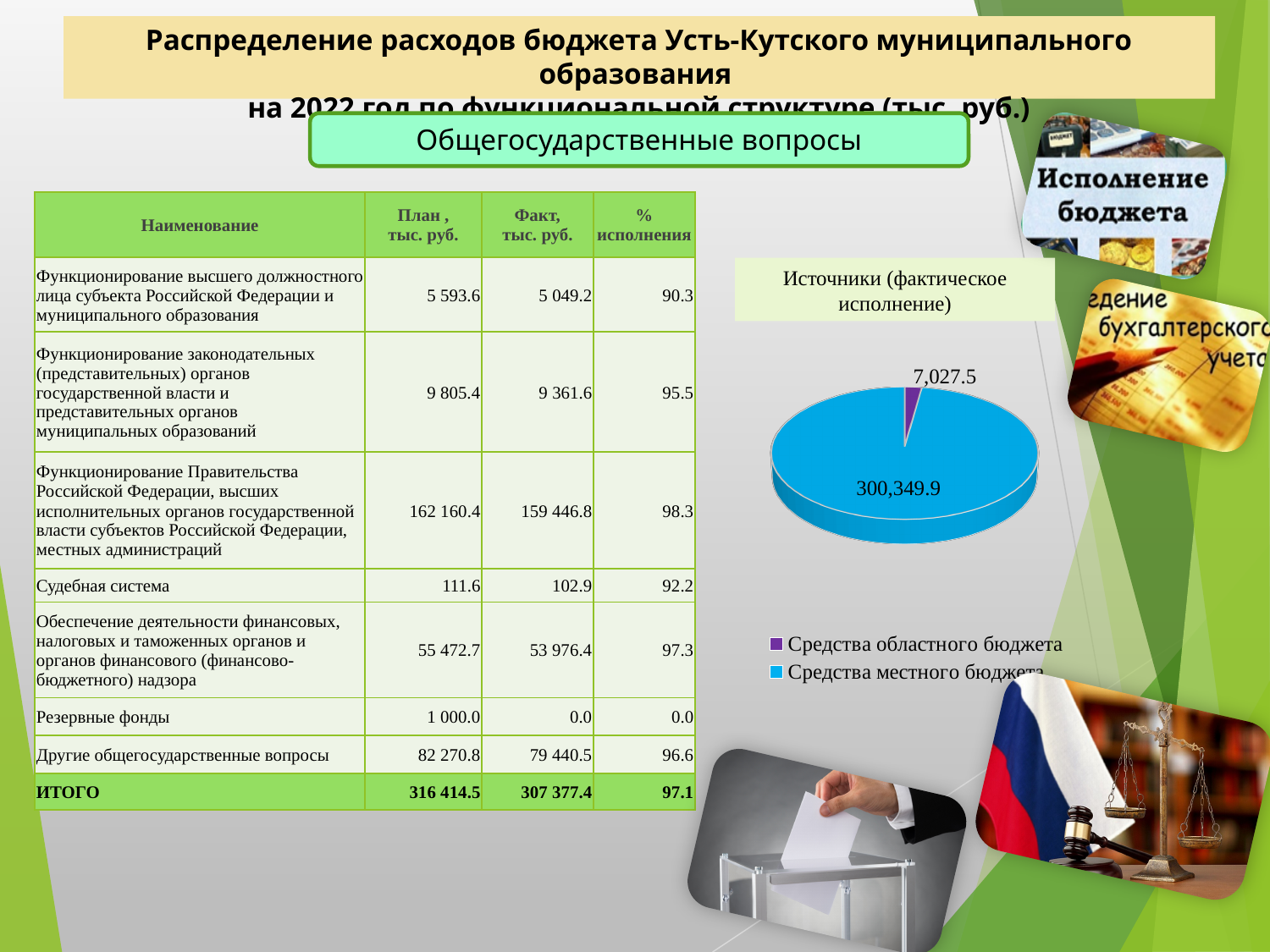
What is the value for Средства местного бюджета in the pie chart? 300,349.9 What is the value for Средства областного бюджета in the pie chart? 7,027.5 How many series does the legend of the pie chart list? 2 Which is larger in the pie chart: Средства областного бюджета or Средства местного бюджета? Средства местного бюджета Which slice of the pie chart is the largest? Средства местного бюджета What is the total of the two slices in the pie chart? 307,377.4 How many slices does the pie chart have? 2 What kind of chart is shown on the slide? pie chart What colour is the slice for Средства областного бюджета in the pie chart? purple Which slice of the pie chart is the smallest? Средства областного бюджета What is the difference between Средства местного бюджета and Средства областного бюджета in the pie chart? 293,322.4 What is the title of the pie chart? Источники (фактическое исполнение)